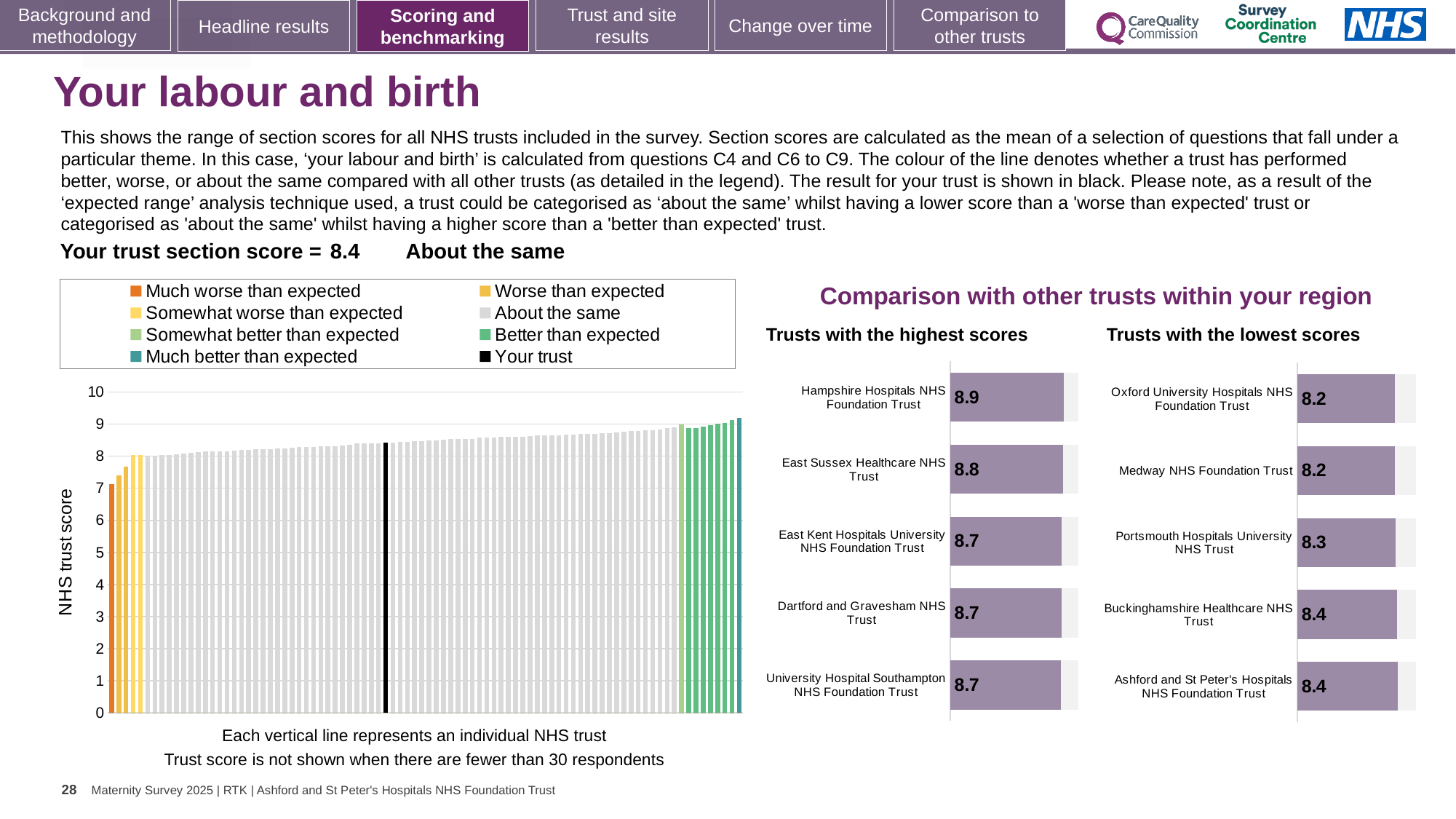
In the 'Trusts with the highest scores' chart, what is the score for Hampshire Hospitals NHS Foundation Trust? 8.9 In the 'Trusts with the lowest scores' chart, what is the score for Portsmouth Hospitals University NHS Trust? 8.3 In the 'Trusts with the highest scores' chart, what is the difference between the scores of Hampshire Hospitals NHS Foundation Trust and East Sussex Healthcare NHS Trust? 0.1 In the 'Trusts with the lowest scores' chart, which is larger: the score for Portsmouth Hospitals University NHS Trust or Oxford University Hospitals NHS Foundation Trust? Portsmouth Hospitals University NHS Trust How many trusts are shown in the 'Trusts with the highest scores' chart? 5 In the large chart on the left, do the trust scores rise or fall from left to right along the x axis? Rise What kind of chart is the large chart on the left with the y-axis labelled 'NHS trust score'? Bar chart In the 'Trusts with the lowest scores' chart, what is the difference between the scores of Ashford and St Peter's Hospitals NHS Foundation Trust and Oxford University Hospitals NHS Foundation Trust? 0.2 In the 'Trusts with the highest scores' chart, what is the score for East Sussex Healthcare NHS Trust? 8.8 In the 'Trusts with the lowest scores' chart, what is the score for Ashford and St Peter's Hospitals NHS Foundation Trust? 8.4 In the 'Trusts with the highest scores' chart, which trust has the highest score? Hampshire Hospitals NHS Foundation Trust How many entries does the legend of the large chart on the left list? 8